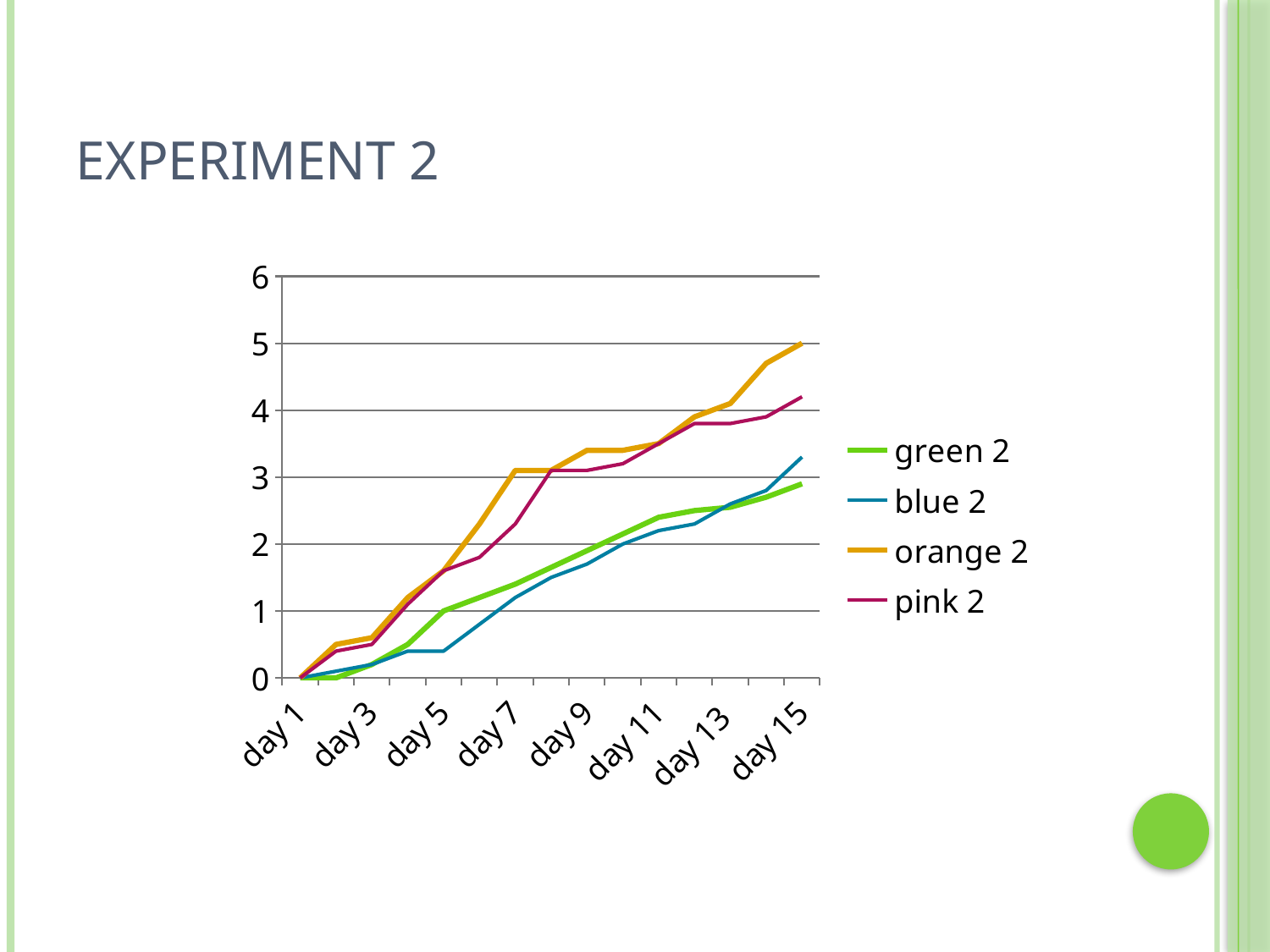
What is the value of orange 2 at day 15? 5 What is the title of the slide containing the chart? EXPERIMENT 2 Do the values of the orange 2 series rise or fall from day 1 to day 15? rise At day 7, which series has the larger value, orange 2 or blue 2? orange 2 What is the value of blue 2 at day 1? 0 What kind of chart is shown on the slide? line chart How many series does the legend list? 4 Is the value for pink 2 at day 15 greater or less than 4? greater Which series has the lowest value at day 15? green 2 Is the value for blue 2 at day 5 greater or less than 1? less Which series has the highest value at day 15? orange 2 Which series are listed in the legend? green 2, blue 2, orange 2, pink 2